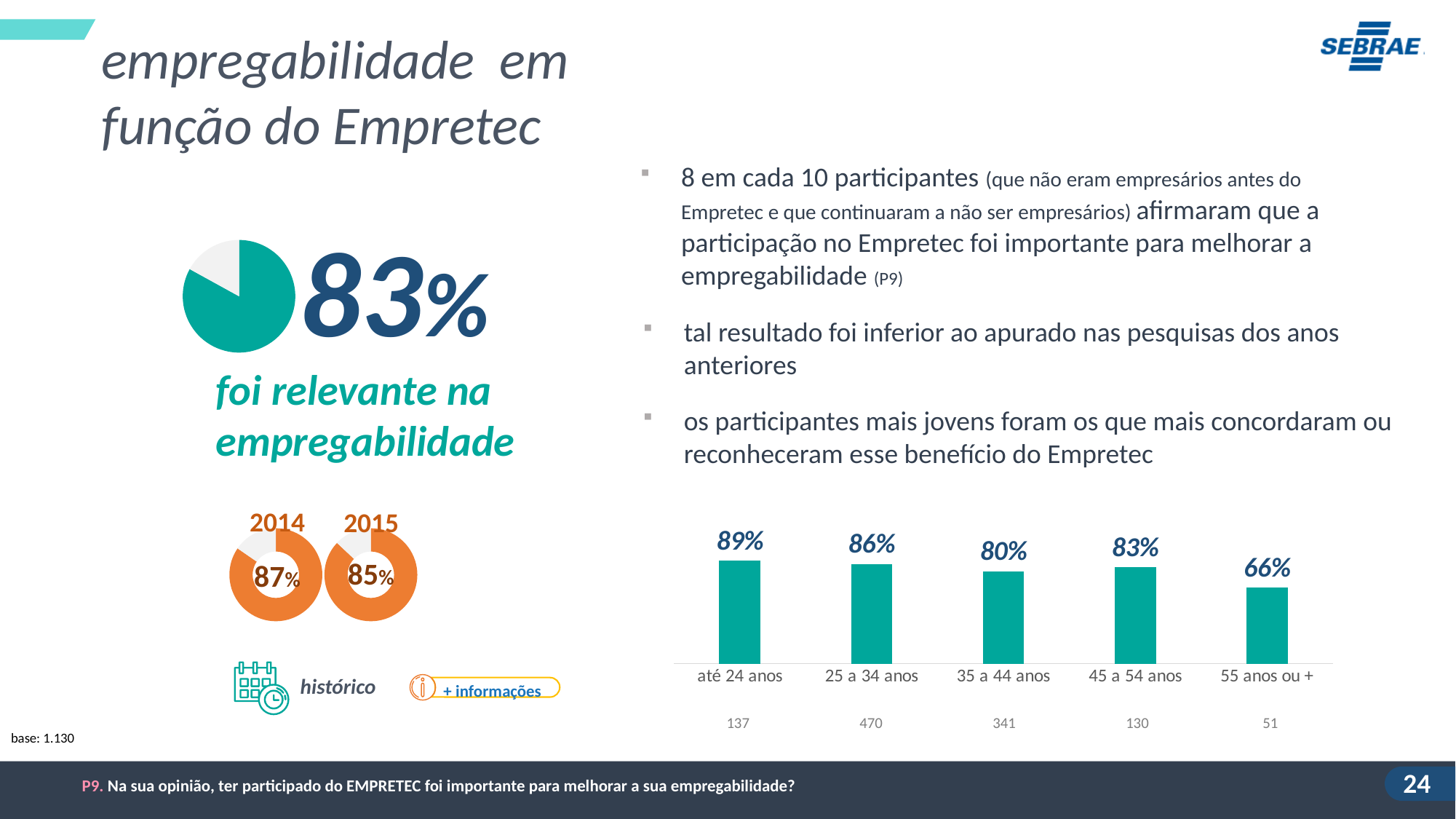
In the bar chart by age group on the right, what is the difference between the values for 'até 24 anos' and '55 anos ou +'? 23% In the bar chart by age group on the right, which is larger: the value for '35 a 44 anos' or '45 a 54 anos'? 45 a 54 anos In the bar chart by age group on the right, which age group has the lowest value? 55 anos ou + How many age groups are shown in the bar chart on the right? 5 What percentage is shown in the large pie chart on the left of the slide? 83% In the bar chart by age group on the right, what base number is shown under '25 a 34 anos'? 470 In the small donut charts labelled 'histórico', what is the difference between the 2014 and 2015 values? 2% In the bar chart by age group on the right, which age group has the highest value? até 24 anos In the bar chart by age group on the right, what is the value for '55 anos ou +'? 66% In the bar chart by age group on the right, what is the value for '25 a 34 anos'? 86% In the small donut charts labelled 'histórico', what is the value for 2014? 87% What kind of chart is used to show the results by age group on the right of the slide? bar chart